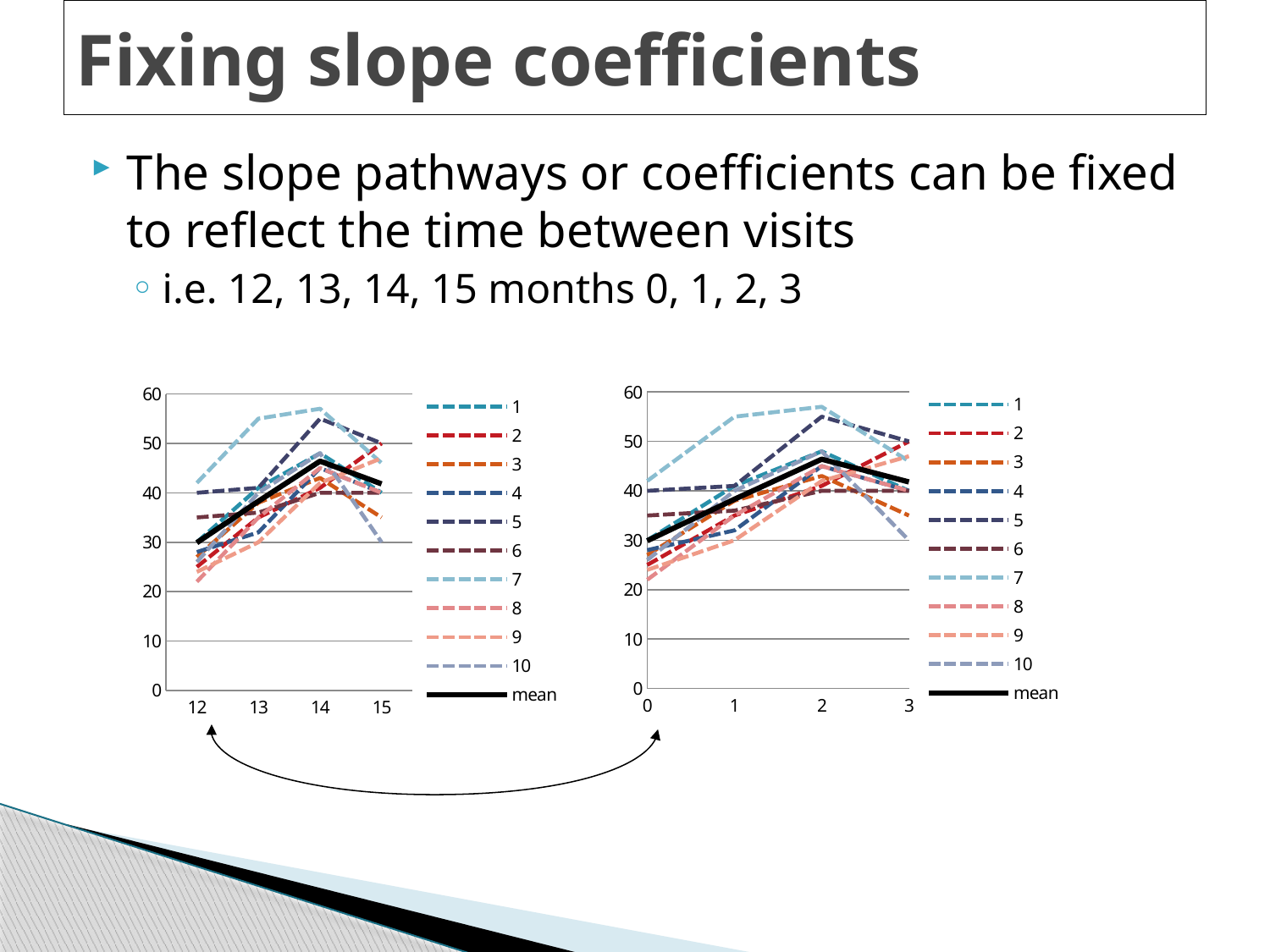
In the left chart, does the mean line rise or fall from 12 to 14? rise What kind of chart is the left chart on the slide? line chart What are the x-axis labels of the right chart? 0, 1, 2, 3 In the left chart, is the value of series 9 at 12 greater or less than 30? less How many series does the legend of the right chart list? 11 In the right chart, is the value of series 7 at 2 greater or less than 50? greater In the right chart, at 1, which is larger: series 7 or series 9? 7 In the left chart, which series has the highest value at 13? 7 In the right chart, does the mean line rise or fall from 2 to 3? fall How many points are on the x axis of the left chart? 4 What is the label of the solid black line in the legend of the left chart? mean In the left chart, is the value of the mean line at 14 greater or less than 40? greater